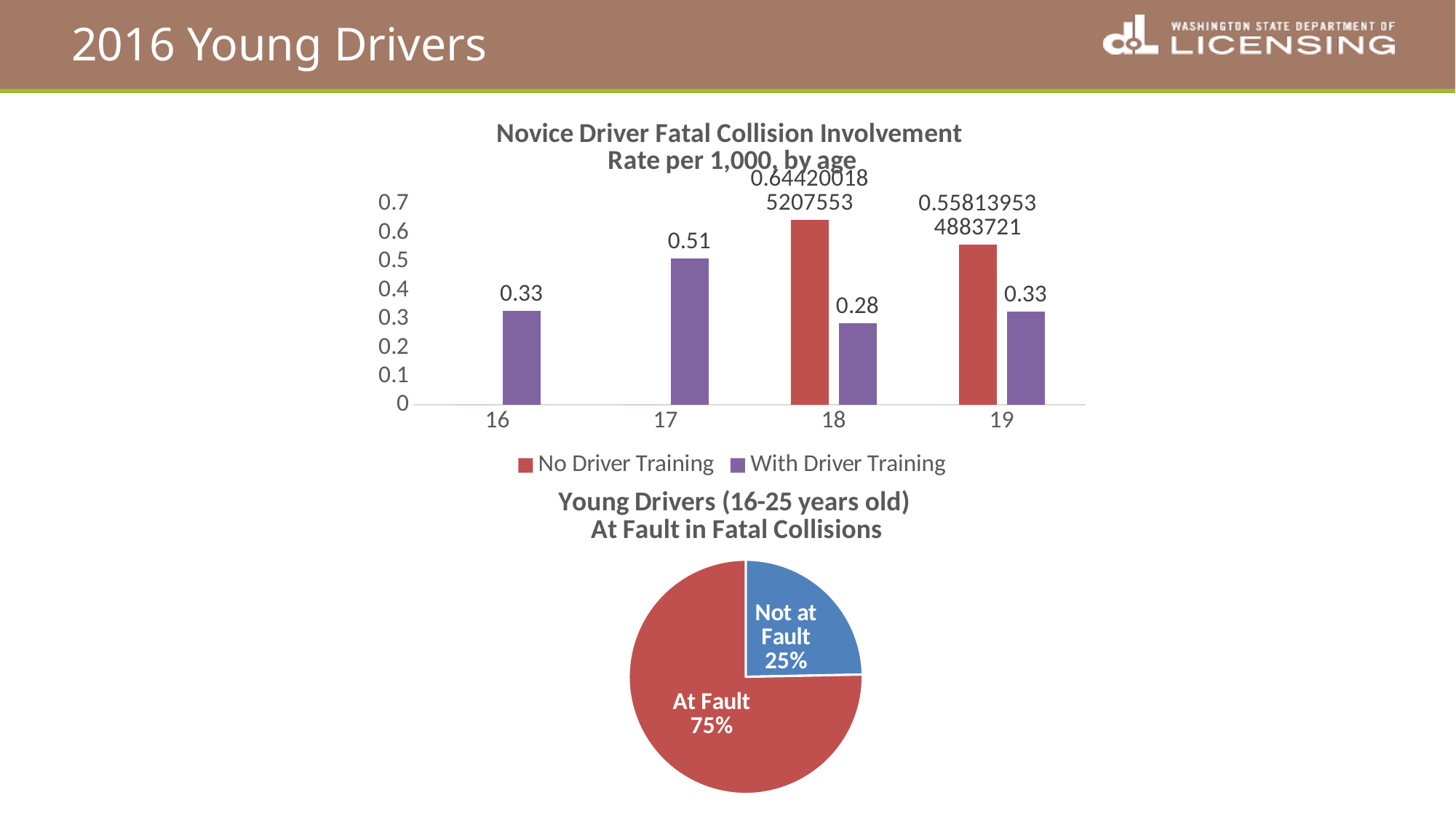
In the 'Young Drivers (16-25 years old) At Fault in Fatal Collisions' pie chart, what share is At Fault? 75% In the 'Novice Driver Fatal Collision Involvement' chart, what is the rate for age 16 with driver training? 0.33 How many age categories are shown on the x axis of the 'Novice Driver Fatal Collision Involvement' chart? 4 In the 'Novice Driver Fatal Collision Involvement' chart, what is the rate for age 18 with driver training? 0.28 In the 'Novice Driver Fatal Collision Involvement' chart, what is the difference between the With Driver Training rates for age 17 and age 18? 0.23 What kind of chart is the 'Young Drivers (16-25 years old) At Fault in Fatal Collisions' chart? pie chart In the 'Novice Driver Fatal Collision Involvement' chart, is the No Driver Training value for age 19 greater or less than 0.5? greater In the 'Novice Driver Fatal Collision Involvement' chart, which age has the highest rate for the With Driver Training series? 17 In the 'Novice Driver Fatal Collision Involvement' chart, at age 18, which series has the larger value: No Driver Training or With Driver Training? No Driver Training How many series does the legend of the 'Novice Driver Fatal Collision Involvement' chart list? 2 In the 'Novice Driver Fatal Collision Involvement' chart, which age has the lowest rate for the With Driver Training series? 18 In the 'Novice Driver Fatal Collision Involvement' chart, what is the rate for age 17 with driver training? 0.51